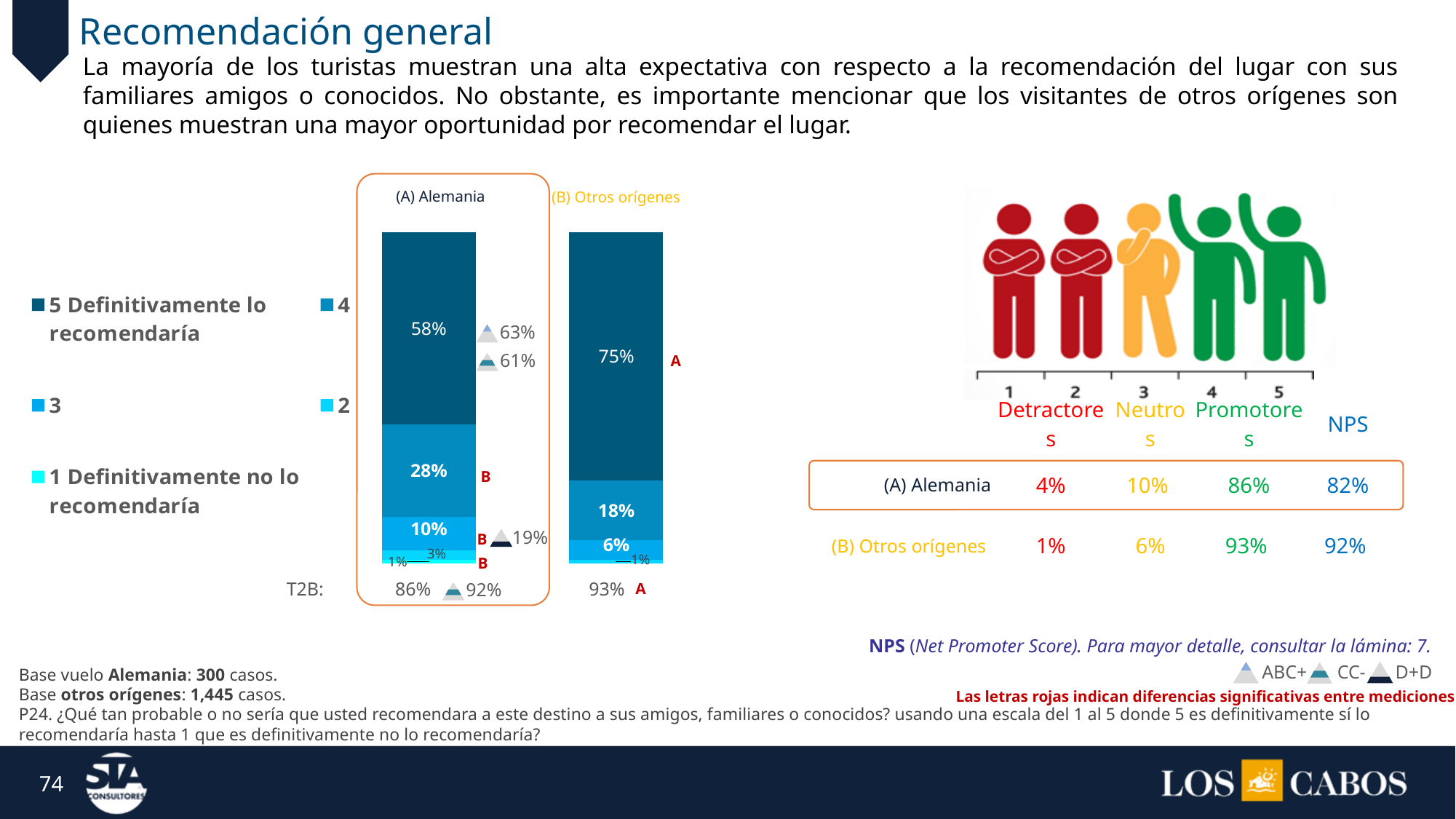
In the stacked bar chart, what is the value of the '3' segment for (B) Otros orígenes? 6% How many bars (groups) are shown in the stacked bar chart? 2 In the NPS table, what is the NPS value for (A) Alemania? 82% What is the T2B value shown for (B) Otros orígenes? 93% In the stacked bar chart, what percentage of (B) Otros orígenes respondents answered '5 Definitivamente lo recomendaría'? 75% In the stacked bar chart, what percentage of (A) Alemania respondents answered '5 Definitivamente lo recomendaría'? 58% What is the T2B value shown for (A) Alemania? 86% Which group has the larger '5 Definitivamente lo recomendaría' share, (A) Alemania or (B) Otros orígenes? (B) Otros orígenes What type of chart is used to show the recommendation scale results for (A) Alemania and (B) Otros orígenes? Stacked bar chart How many series does the legend of the stacked bar chart list? 5 In the stacked bar chart, what is the value of the '4' segment for (A) Alemania? 28% What is the difference between the '5 Definitivamente lo recomendaría' shares of (B) Otros orígenes and (A) Alemania? 17 percentage points